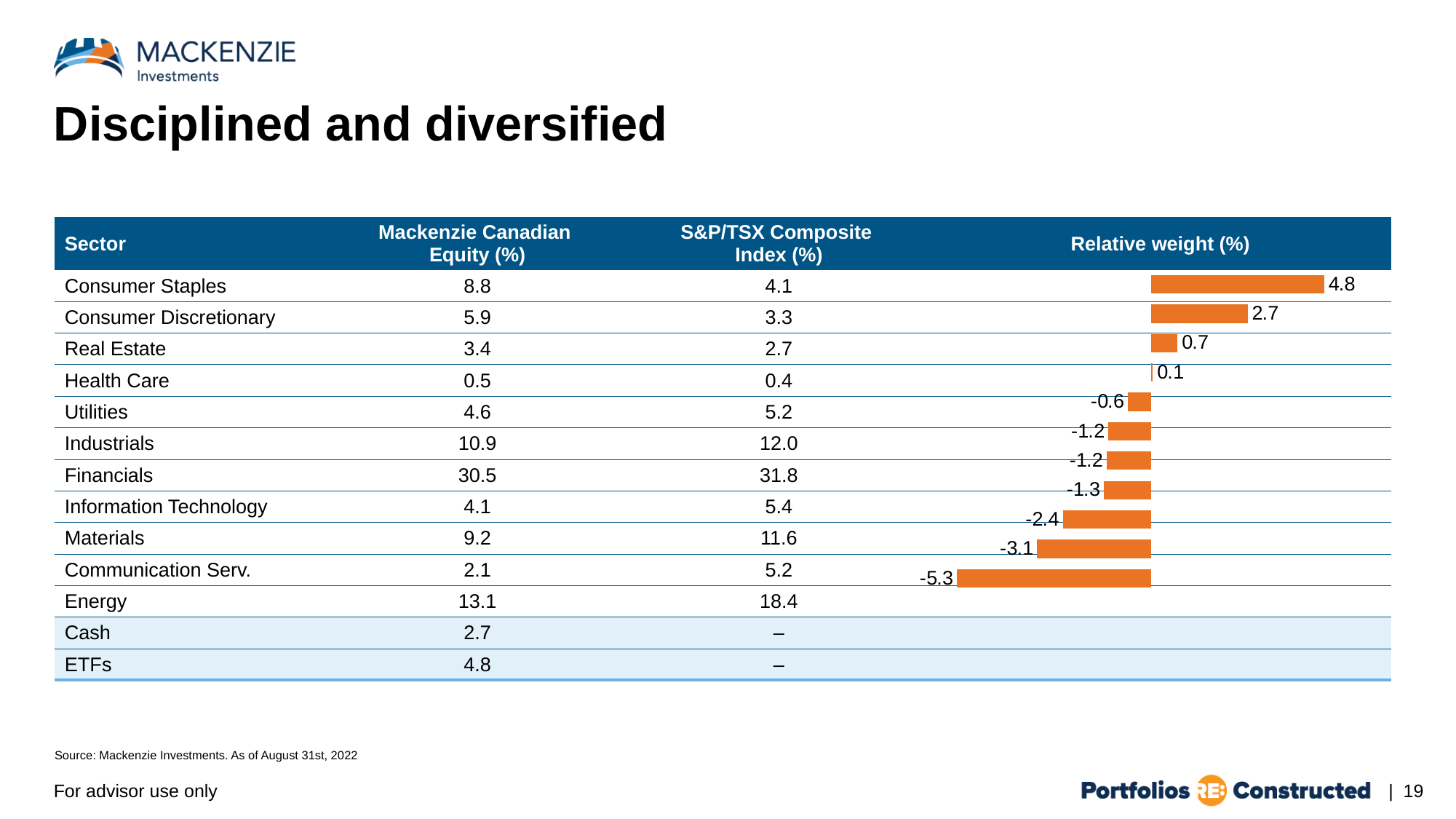
What is the relative weight (%) shown for Real Estate? 0.7 What is the relative weight (%) shown for Health Care? 0.1 What kind of chart is shown in the Relative weight (%) column? bar chart What is the relative weight (%) shown for Consumer Staples? 4.8 How many bars in the Relative weight (%) chart have negative values? 7 What is the relative weight (%) shown for Consumer Discretionary? 2.7 What is the highest relative weight value shown in the chart? 4.8 What is the difference between the relative weight for Consumer Staples and Consumer Discretionary? 2.1 How many bars are plotted in the Relative weight (%) chart? 11 Which has the larger relative weight, Consumer Staples or Real Estate? Consumer Staples What is the lowest relative weight value shown in the chart? -5.3 What colour are the bars in the Relative weight (%) chart? orange